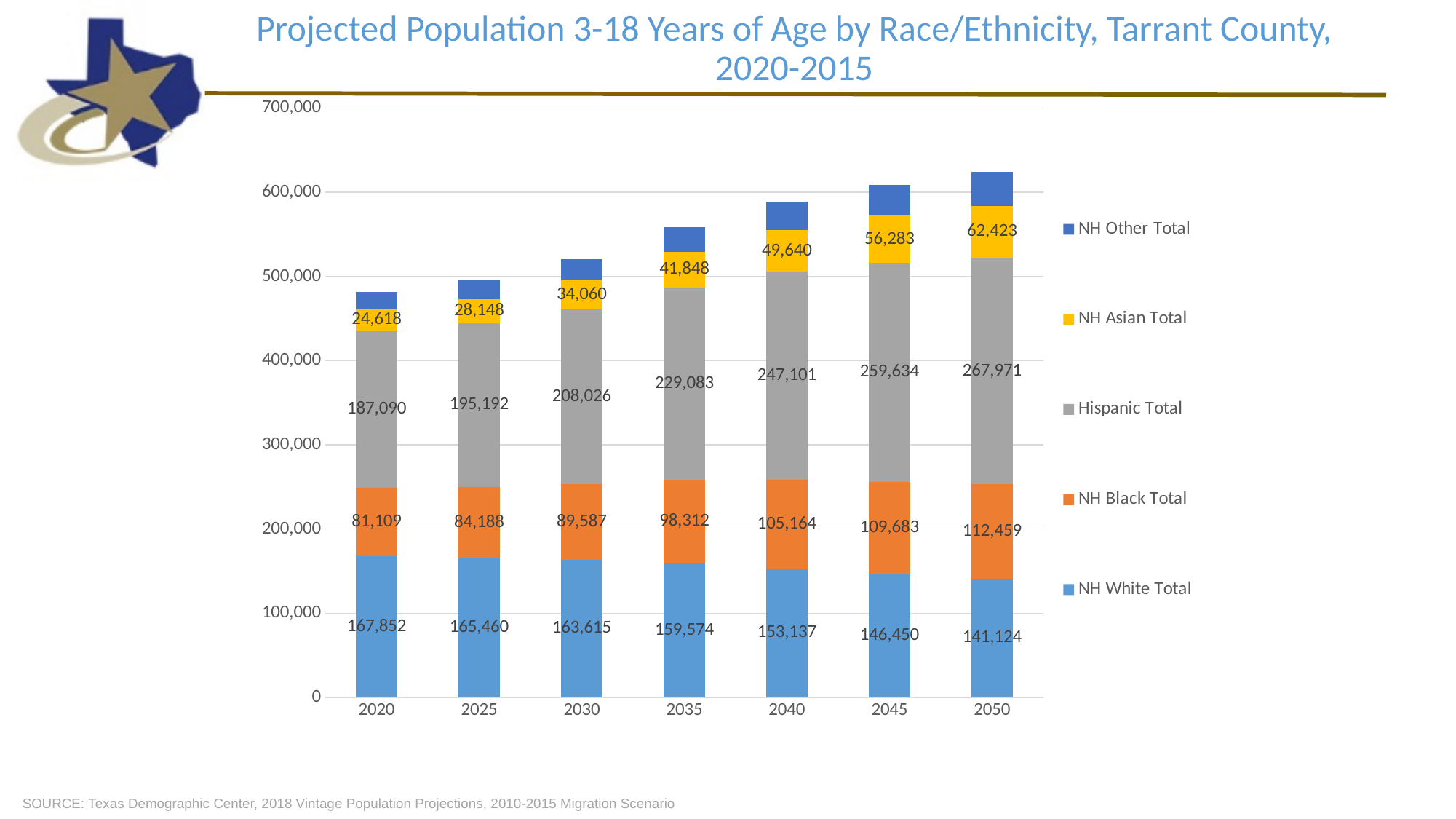
In 2040, which is larger: the NH White Total or the NH Black Total? NH White Total What is the NH Asian Total value for 2020? 24,618 How many years are shown on the x axis? 7 What is the difference between the NH Asian Total in 2050 and in 2045? 6,140 In which year is the NH White Total lowest? 2050 What is the Hispanic Total value for 2035? 229,083 Does the NH White Total rise or fall from 2020 to 2050? fall What is the NH White Total value for 2050? 141,124 Is the total height of the 2050 stacked bar greater or less than 600,000? greater How many series does the legend list? 5 In which year is the Hispanic Total highest? 2050 How much larger is the NH Black Total in 2050 than in 2020? 31,350